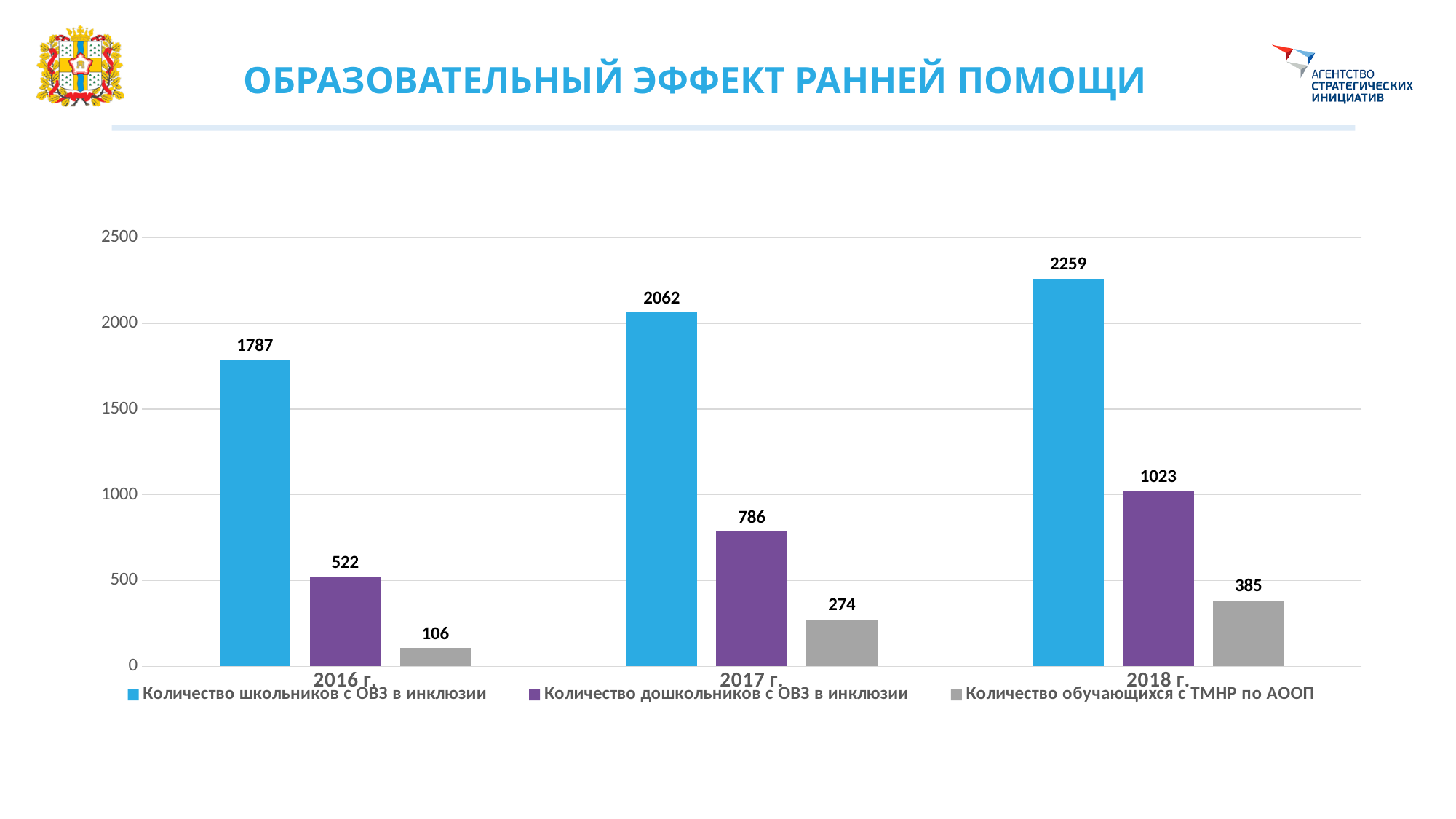
What is the value for 'Количество дошкольников с ОВЗ в инклюзии' in 2017 г.? 786 Which is larger: 'Количество дошкольников с ОВЗ в инклюзии' in 2018 г. or 'Количество школьников с ОВЗ в инклюзии' in 2016 г.? Количество школьников с ОВЗ в инклюзии in 2016 г. What is the value for 'Количество школьников с ОВЗ в инклюзии' in 2016 г.? 1787 In which year is 'Количество обучающихся с ТМНР по АООП' lowest? 2016 г. What is the value for 'Количество обучающихся с ТМНР по АООП' in 2018 г.? 385 Does 'Количество обучающихся с ТМНР по АООП' rise or fall from 2016 г. to 2018 г.? Rise How many years are shown on the x axis? 3 How many series does the legend list? 3 What is the difference between 'Количество дошкольников с ОВЗ в инклюзии' in 2018 г. and in 2016 г.? 501 What is the difference between 'Количество школьников с ОВЗ в инклюзии' in 2018 г. and in 2017 г.? 197 In which year is 'Количество школьников с ОВЗ в инклюзии' highest? 2018 г. What kind of chart is shown on the slide? Bar chart